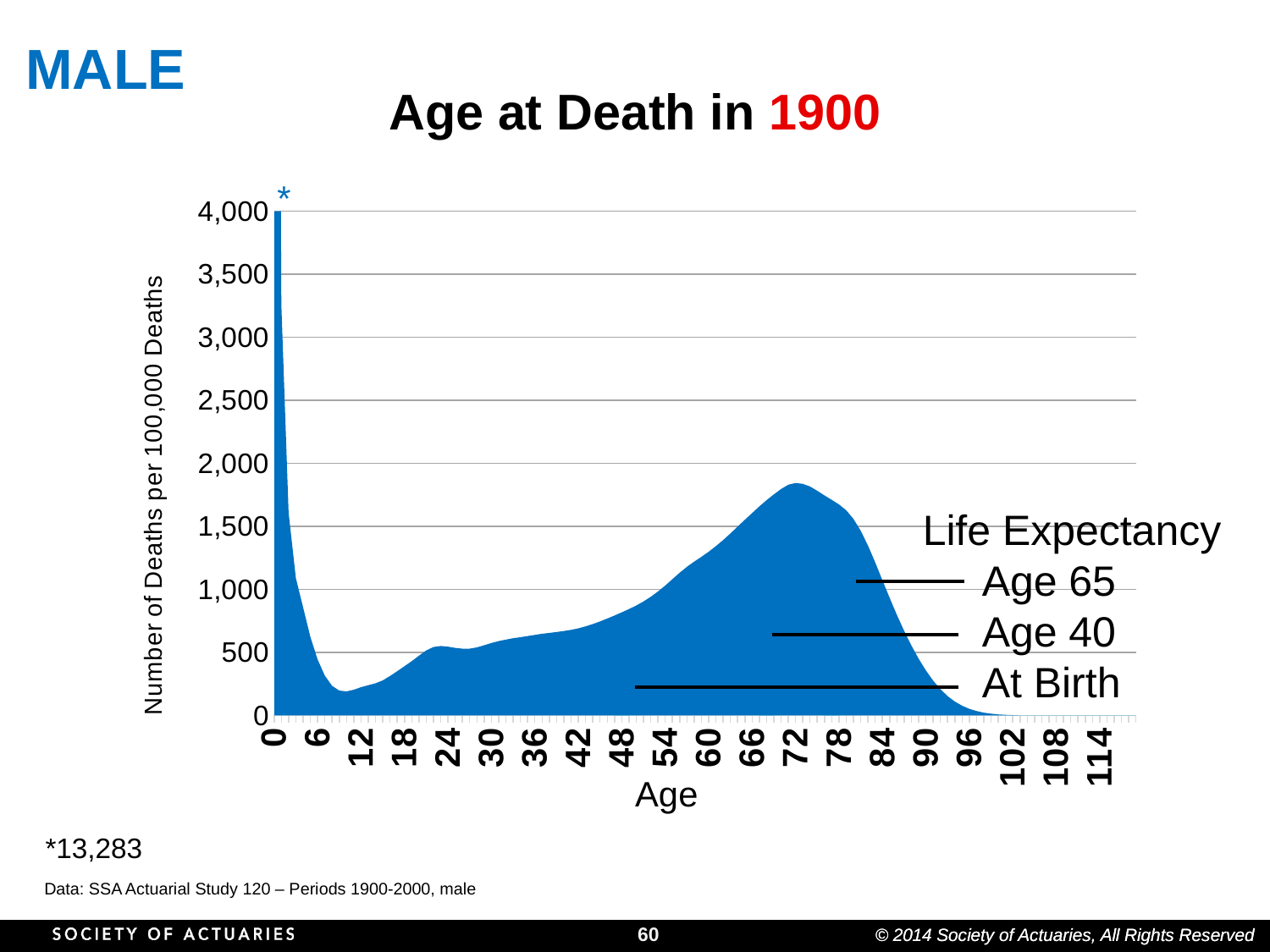
What is the label of the vertical axis? Number of Deaths per 100,000 Deaths Is the value at age 12 greater or less than 500? less At which age is the number of deaths per 100,000 highest? 0 Which age has a higher value, age 72 or age 24? age 72 Is the value at age 24 greater or less than 1,000? less What kind of chart is shown on the slide? area chart What is the number of deaths per 100,000 at age 0, as given by the asterisk footnote? 13,283 Is the value at age 72 greater or less than 1,500? greater Do the values rise or fall along the x axis between age 12 and age 72? rise Do the values rise or fall along the x axis between age 72 and age 102? fall What is the title of the chart? Age at Death in 1900